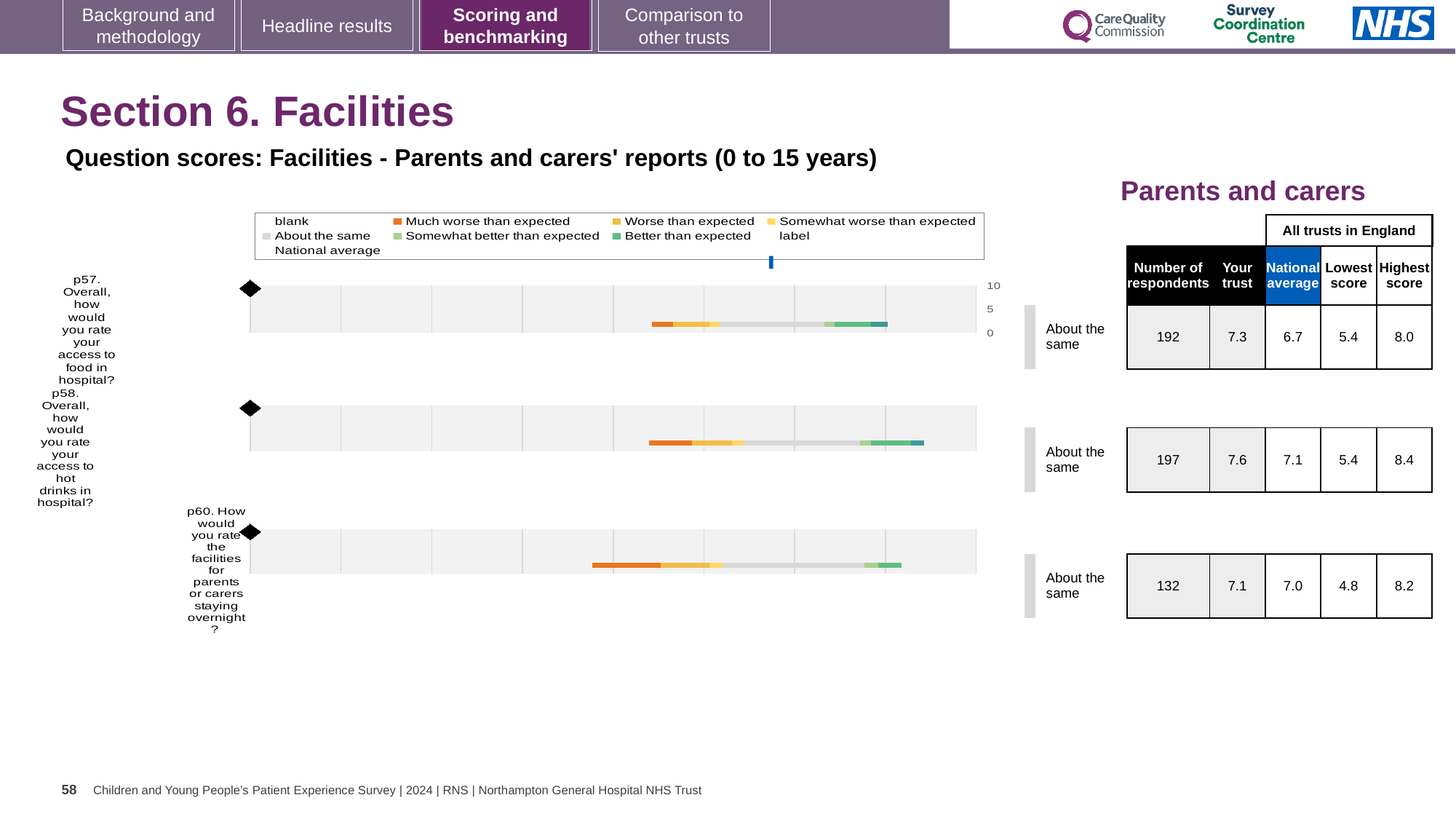
Which question has the highest 'Your trust' score: p57, p58 or p60? p58 In the chart legend, which category is shown in orange? Much worse than expected For p58 (access to hot drinks in hospital), what is the National average score? 7.1 Which question has the lowest 'Lowest score' across all trusts in England? p60 How many respondents are listed for p60 (facilities for parents or carers staying overnight)? 132 For p57 (access to food in hospital), what is the 'Your trust' score shown in the table? 7.3 How many questions (p57, p58, p60) have a chart plotted on the slide? 3 What benchmark category label is shown next to each of the three charts? About the same What is the Highest score across all trusts in England for p58? 8.4 For p57, what is the difference between the 'Your trust' score and the National average? 0.6 What kind of chart is used to show the question scores for p57, p58 and p60? bar chart Which has the larger 'Your trust' score: p58 or p60? p58